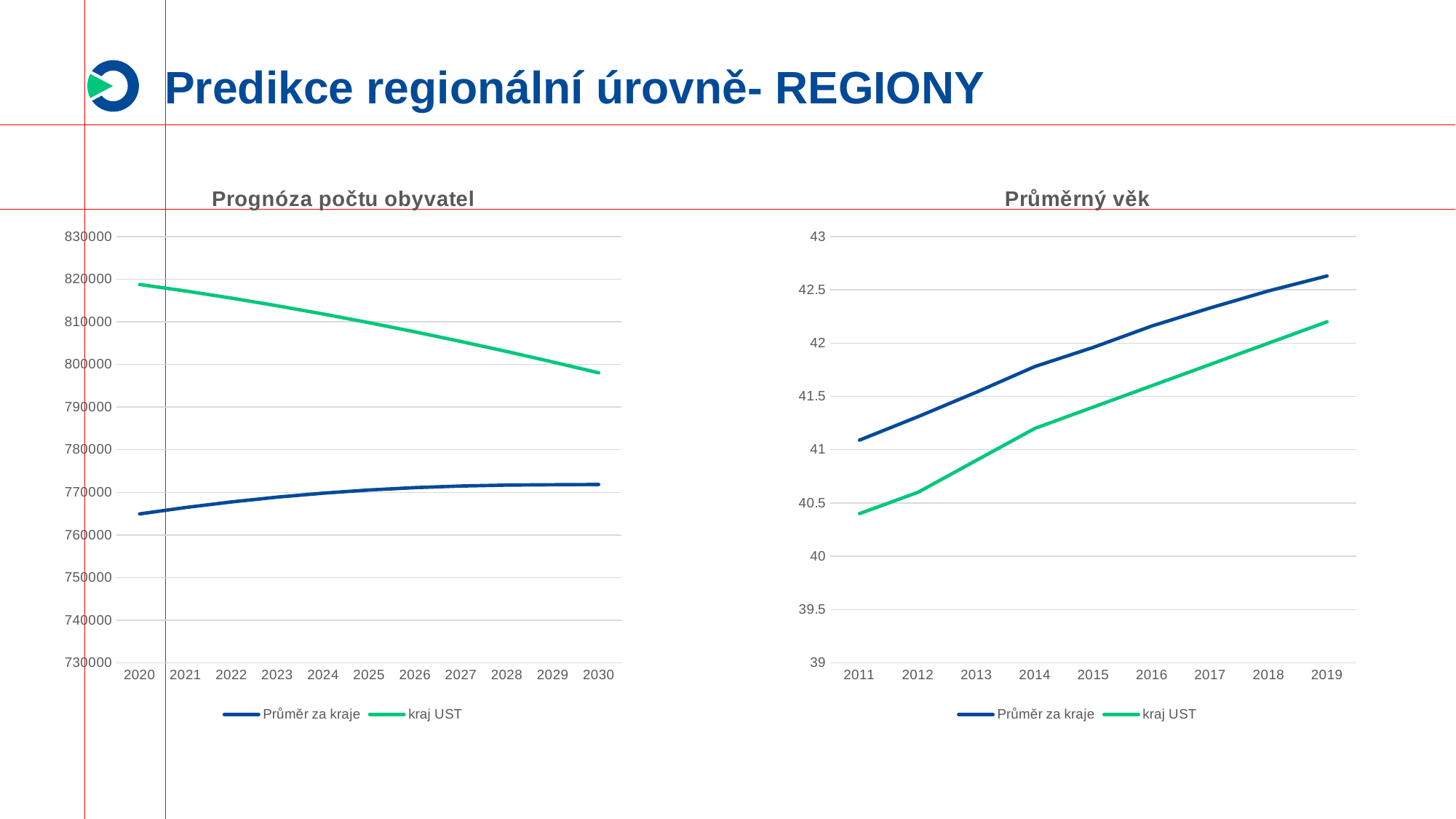
In the 'Prognóza počtu obyvatel' chart, does the kraj UST line rise or fall from 2020 to 2030? fall How many years are shown on the x axis of the 'Průměrný věk' chart? 9 What colour is the kraj UST line in the 'Průměrný věk' chart? green In the 'Prognóza počtu obyvatel' chart, is the value for kraj UST in 2020 greater or less than 810000? greater In the 'Průměrný věk' chart, does the kraj UST line rise or fall from 2011 to 2019? rise How many years are shown on the x axis of the 'Prognóza počtu obyvatel' chart? 11 In the 'Průměrný věk' chart, is the value for kraj UST in 2011 greater or less than 41? less In the 'Průměrný věk' chart, which series is higher in 2011, Průměr za kraje or kraj UST? Průměr za kraje What kind of chart is the 'Prognóza počtu obyvatel' chart? line chart In the 'Prognóza počtu obyvatel' chart, is the value for Průměr za kraje in 2020 greater or less than 770000? less In the 'Prognóza počtu obyvatel' chart, which series is higher in 2020, Průměr za kraje or kraj UST? kraj UST How many series does the legend of the 'Průměrný věk' chart list? 2